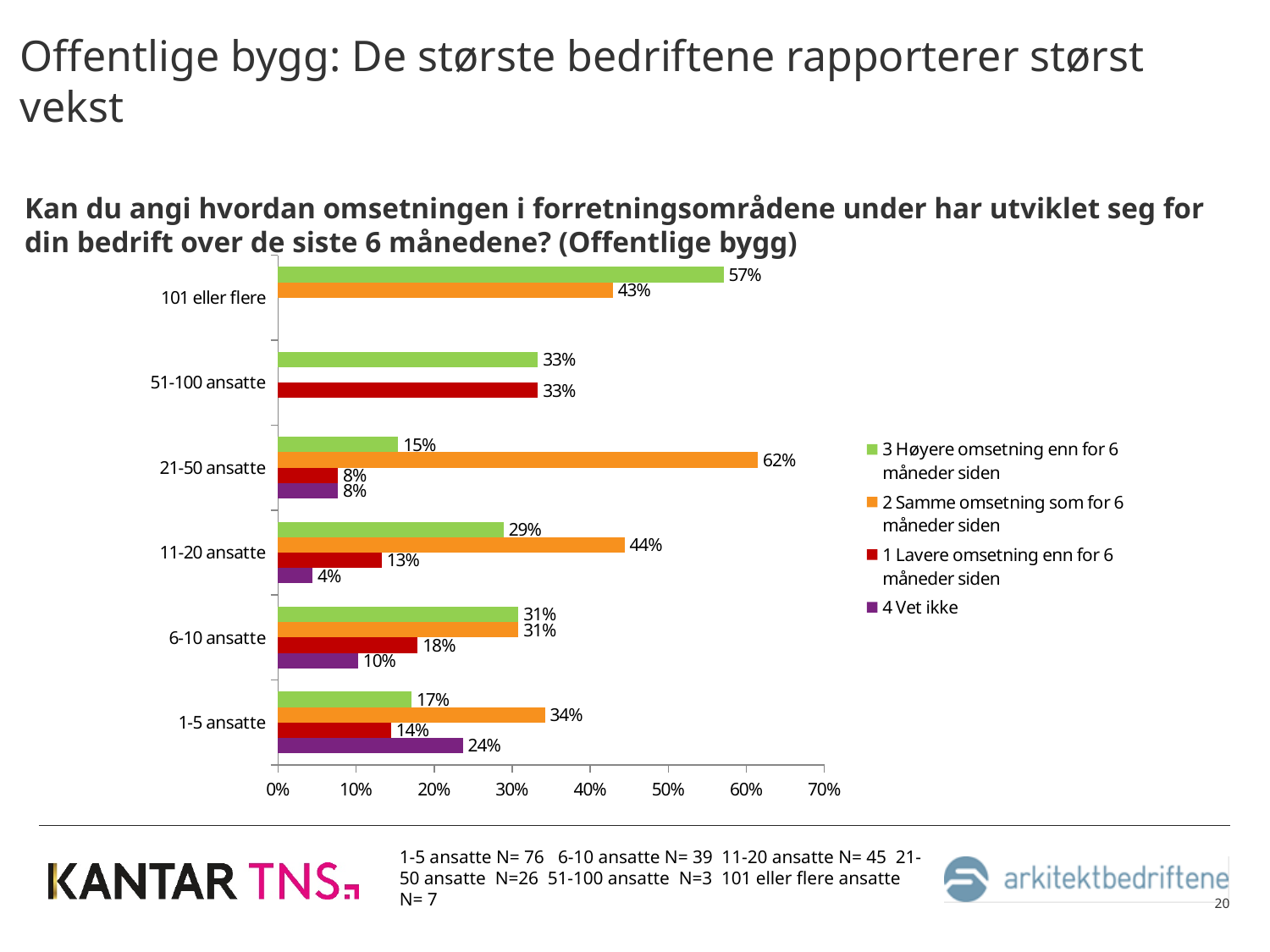
Which category has the highest value for '3 Høyere omsetning enn for 6 måneder siden'? 101 eller flere What is the value for '4 Vet ikke' for '1-5 ansatte'? 24% How many series does the legend list? 4 What is the value for '1 Lavere omsetning enn for 6 måneder siden' for '6-10 ansatte'? 18% Which colour represents '4 Vet ikke' in the legend? purple What kind of chart is shown on the slide? bar chart What is the difference between the '2 Samme omsetning som for 6 måneder siden' value and the '3 Høyere omsetning enn for 6 måneder siden' value for '21-50 ansatte'? 47% Which category has the lowest value for '4 Vet ikke'? 11-20 ansatte What is the value for '3 Høyere omsetning enn for 6 måneder siden' for '101 eller flere'? 57% How many company-size categories are shown on the chart? 6 For '11-20 ansatte', which is larger: '3 Høyere omsetning enn for 6 måneder siden' or '2 Samme omsetning som for 6 måneder siden'? 2 Samme omsetning som for 6 måneder siden What is the value for '2 Samme omsetning som for 6 måneder siden' for '21-50 ansatte'? 62%